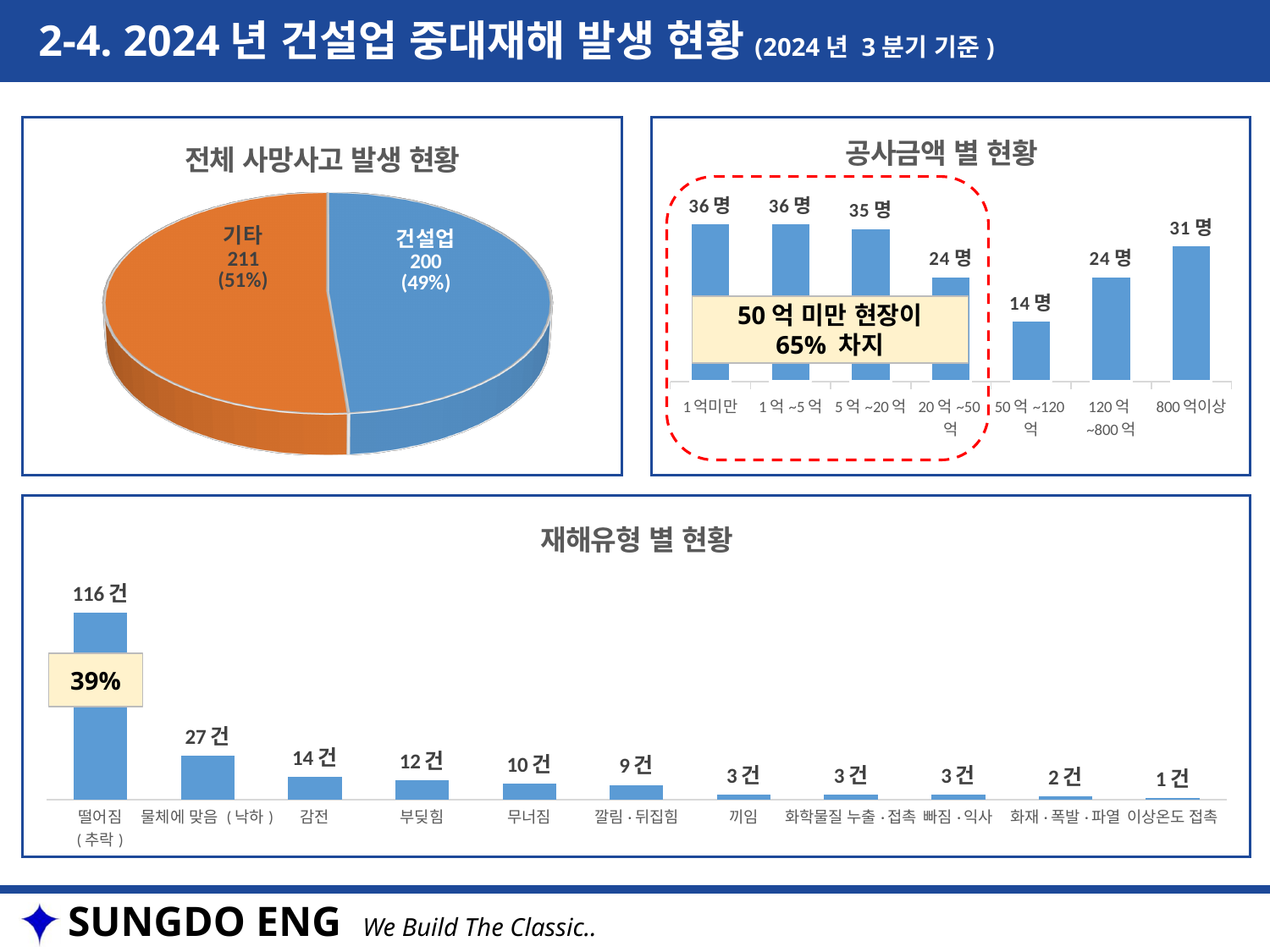
In the chart '공사금액 별 현황', how many categories are shown on the x axis? 7 In the pie chart '전체 사망사고 발생 현황', what value is shown for 건설업? 200 (49%) In the pie chart '전체 사망사고 발생 현황', which slice is larger, 기타 or 건설업? 기타 In the chart '공사금액 별 현황', which category has the lowest value? 50억~120억 In the chart '공사금액 별 현황', what is the difference between the values for 1억미만 and 20억~50억? 12 명 In the chart '공사금액 별 현황', what is the value for 800억이상? 31 명 In the chart '재해유형 별 현황', what is the value for 감전? 14 건 In the chart '재해유형 별 현황', what is the difference between the values for 떨어짐(추락) and 물체에 맞음(낙하)? 89 건 In the chart '재해유형 별 현황', how many categories are shown? 11 In the pie chart '전체 사망사고 발생 현황', what share of the pie does 기타 take? 51% What kind of chart is '전체 사망사고 발생 현황'? Pie chart In the chart '재해유형 별 현황', which category has the highest value? 떨어짐(추락)